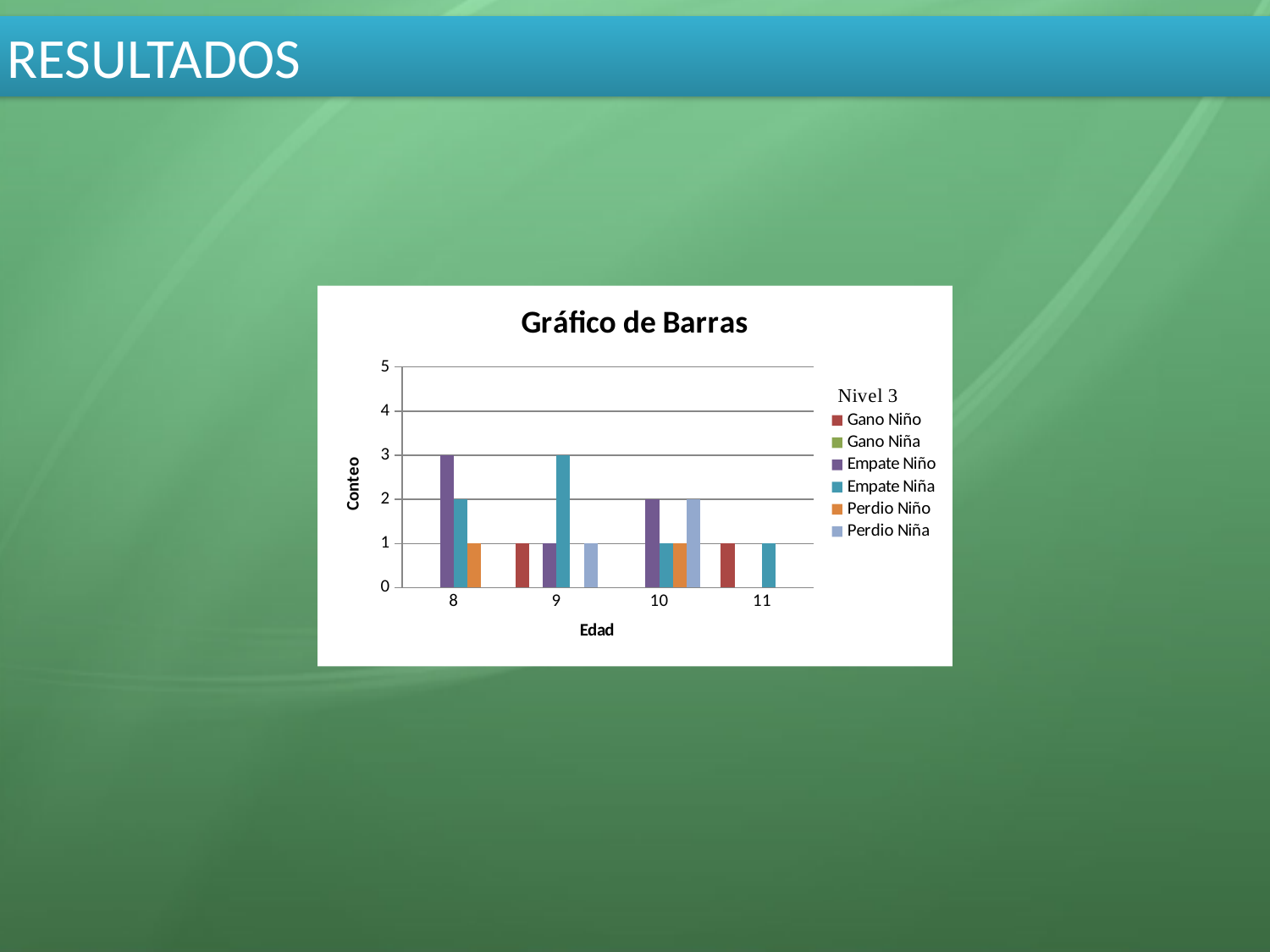
What is the value of Gano Niño for age 11? 1 What is the title of the chart? Gráfico de Barras How many series does the legend list? 6 Which is larger for age 10: Empate Niño or Empate Niña? Empate Niño What is the value of Empate Niño for age 8? 3 How many age categories are shown on the x axis? 4 For age 8, which series has the highest value? Empate Niño What is the difference between Empate Niña for age 9 and Empate Niña for age 11? 2 What is the value of Perdio Niña for age 10? 2 What kind of chart is shown on the slide? bar chart What is the value of Empate Niña for age 9? 3 What is the label of the y axis? Conteo